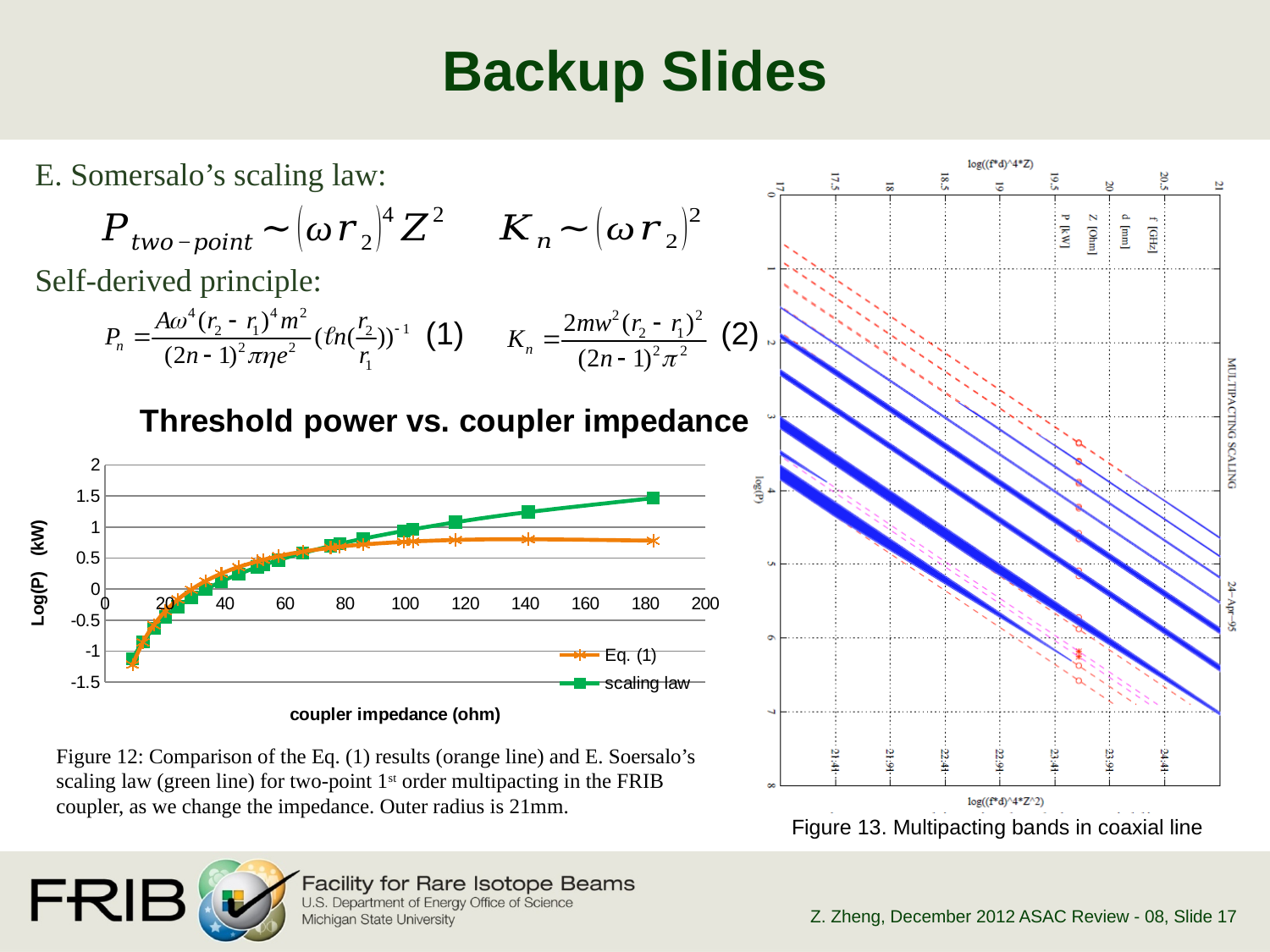
In the "Threshold power vs. coupler impedance" chart, does the scaling law series rise or fall as coupler impedance increases? rise What is the highest value shown on the x axis of the "Threshold power vs. coupler impedance" chart? 200 In the "Threshold power vs. coupler impedance" chart, is the Eq. (1) value at 20 ohm greater or less than 0? less What kind of chart is "Threshold power vs. coupler impedance"? line chart In the "Threshold power vs. coupler impedance" chart, is the scaling law value at 180 ohm greater or less than 1? greater In the "Threshold power vs. coupler impedance" chart, is the scaling law value at 140 ohm greater or less than 1? greater In the "Threshold power vs. coupler impedance" chart, which series has the higher value at 180 ohm, Eq. (1) or scaling law? scaling law How many series does the legend of the "Threshold power vs. coupler impedance" chart list? 2 What is the x-axis label of the "Threshold power vs. coupler impedance" chart? coupler impedance (ohm) What are the two series named in the legend of the "Threshold power vs. coupler impedance" chart? Eq. (1) and scaling law In the "Threshold power vs. coupler impedance" chart, does the Eq. (1) series rise or fall between 0 and 60 ohm? rise